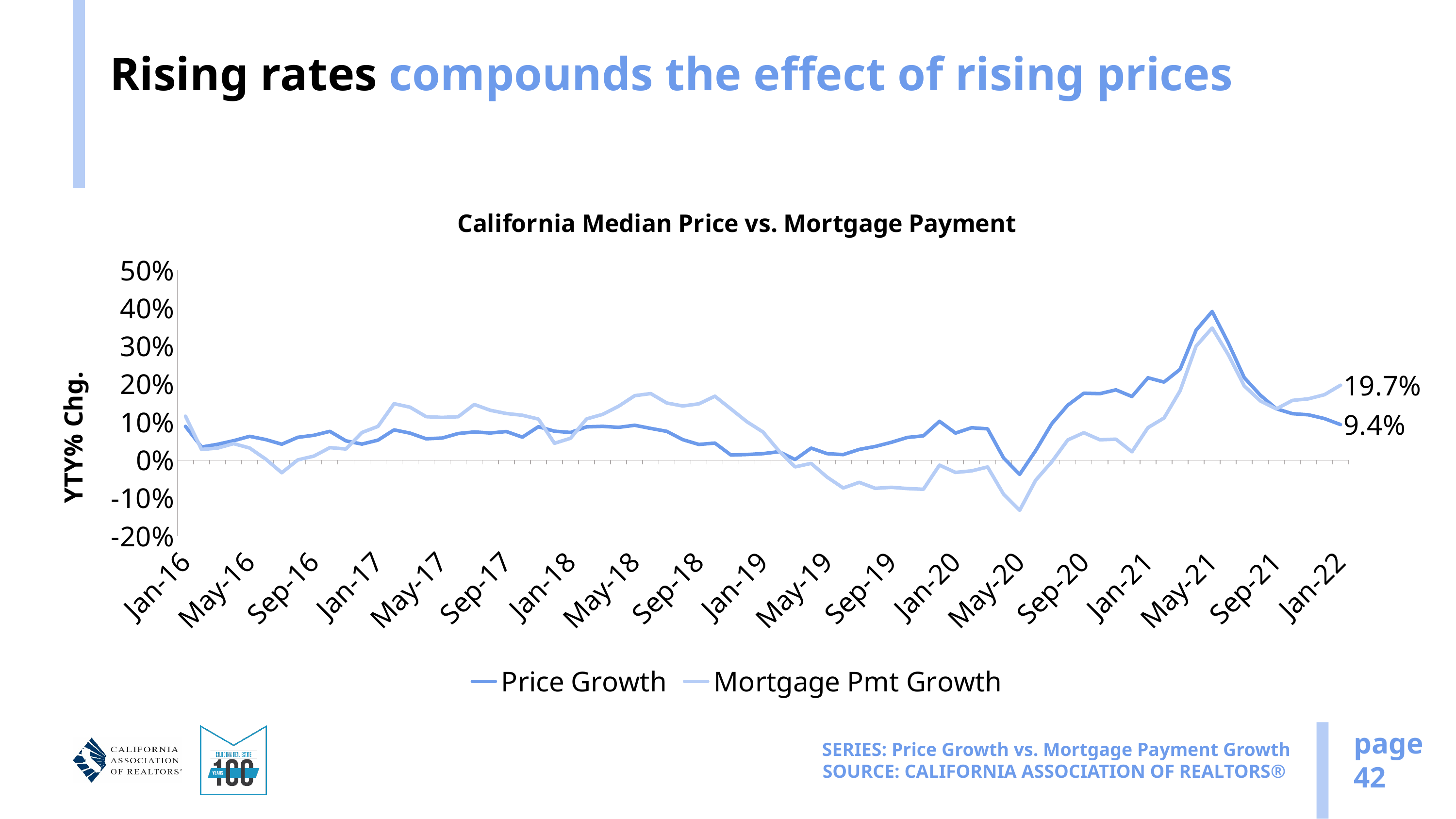
Which series reaches the higher peak around May-21? Price Growth Is the Mortgage Pmt Growth value at May-20 greater or less than -10%? less Does Price Growth rise or fall from May-21 to Jan-22? fall What is the title of the chart? California Median Price vs. Mortgage Payment At Jan-22, which series has the larger value, Price Growth or Mortgage Pmt Growth? Mortgage Pmt Growth What is the difference between Mortgage Pmt Growth and Price Growth at Jan-22? 10.3 percentage points Is the peak Price Growth value around May-21 greater or less than 30%? greater What is the label on the vertical axis? YTY% Chg. What is the Mortgage Pmt Growth value at Jan-22? 19.7% What kind of chart is shown on the slide? line chart How many series does the legend list? 2 What is the Price Growth value at Jan-22? 9.4%